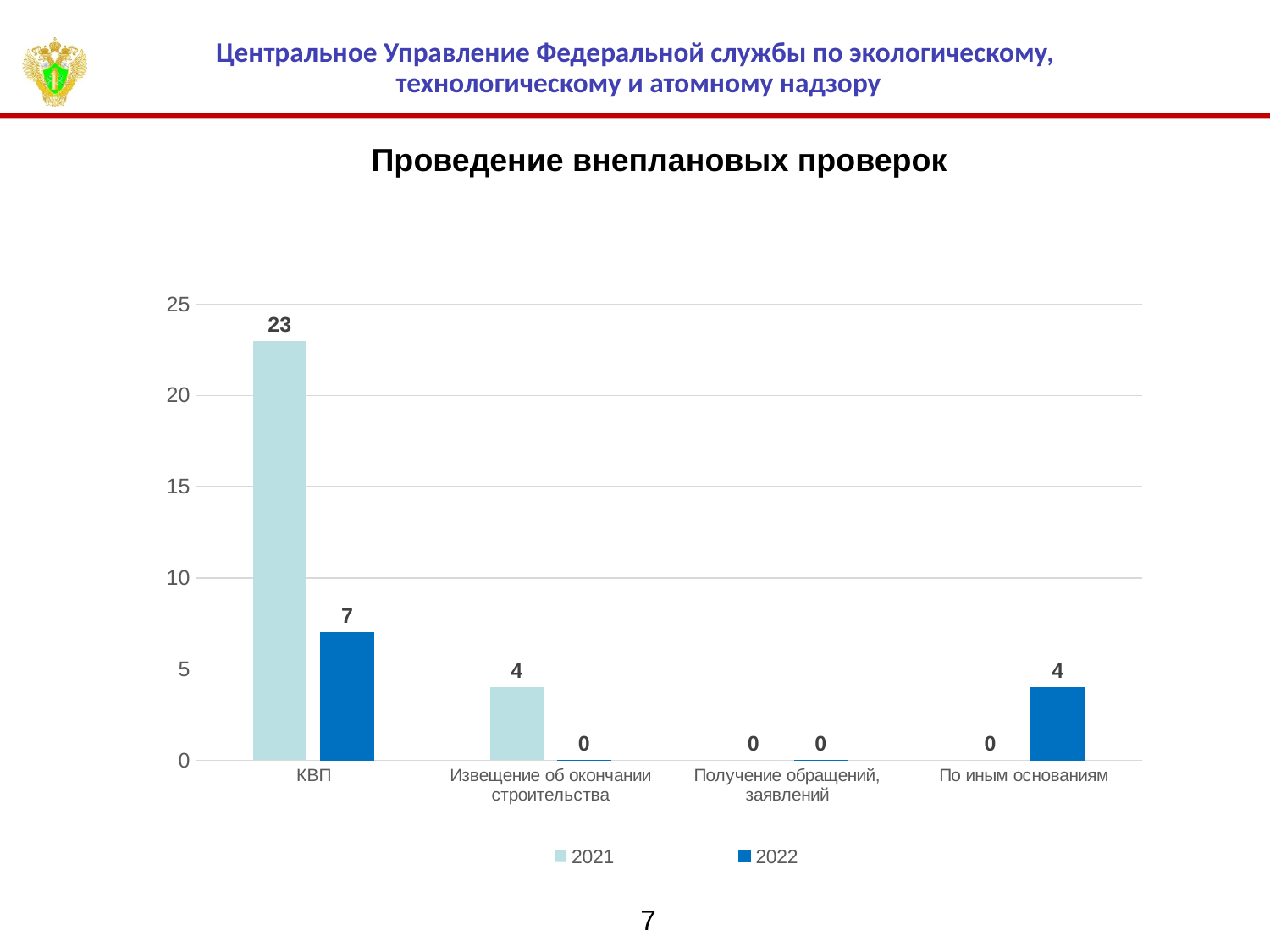
Which category has the highest 2022 value? КВП What is the 2022 value for По иным основаниям? 4 What is the title of the chart? Проведение внеплановых проверок What is the 2021 value for Извещение об окончании строительства? 4 How many series does the legend list? 2 What kind of chart is shown on the slide? bar chart What is the 2022 value for КВП? 7 What is the difference between the 2021 and 2022 values for КВП? 16 How many categories are shown on the x axis? 4 What is the 2021 value for КВП? 23 Which category has the highest 2021 value? КВП Which is larger for КВП: the 2021 value or the 2022 value? 2021